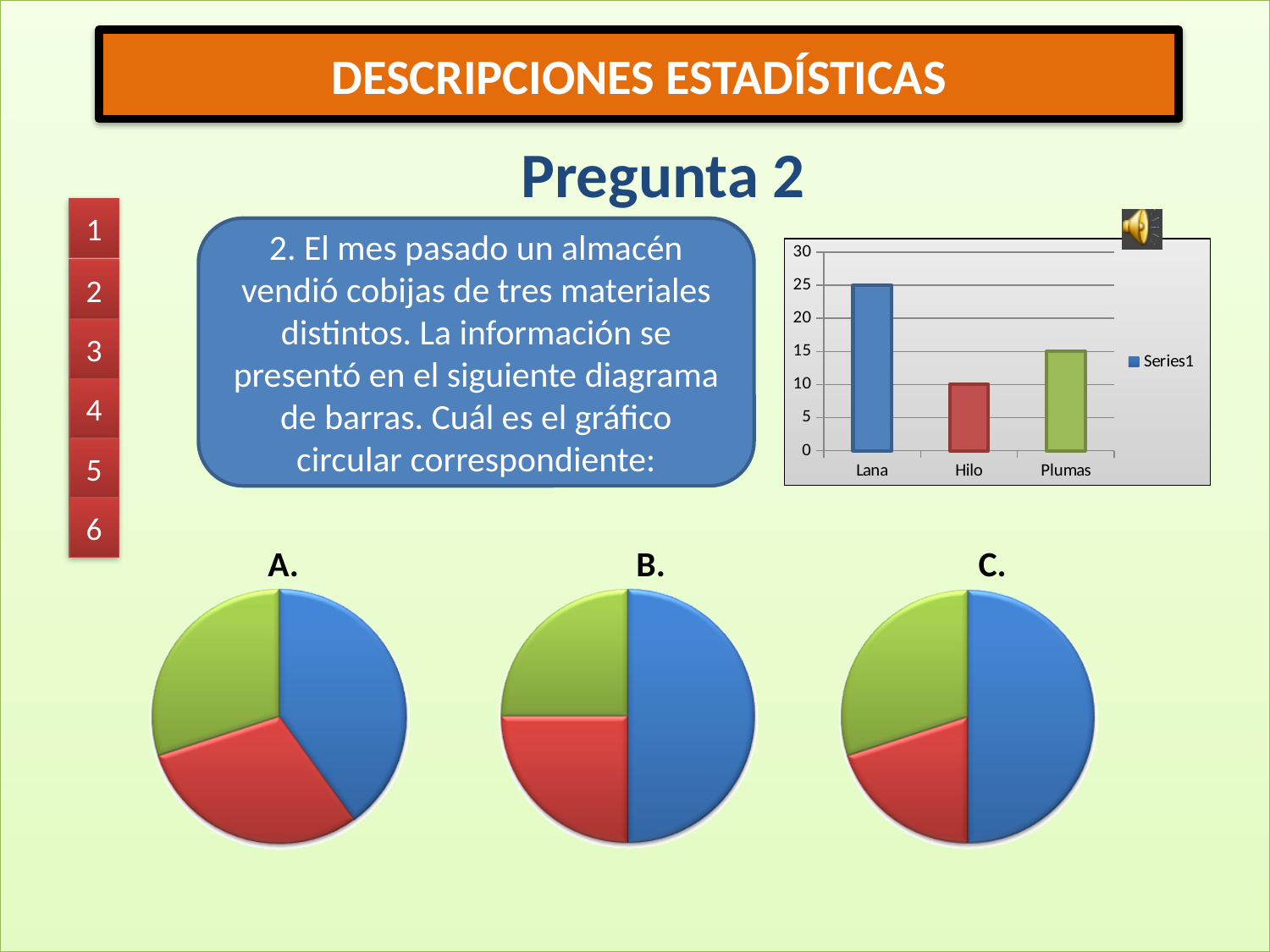
In the bar chart at the top right, which category has the highest value? Lana In the bar chart at the top right, what is the value for Hilo? 10 In the bar chart at the top right, what is the difference between the values for Lana and Hilo? 15 What kind of chart is the chart at the top right of the slide? bar chart In the bar chart at the top right, which category has the lowest value? Hilo In the bar chart at the top right, what is the value for Lana? 25 How many series does the legend of the bar chart at the top right list? 1 What kind of chart is chart B at the bottom of the slide? pie chart In the bar chart at the top right, which is larger, the value for Plumas or the value for Hilo? Plumas How many categories are shown in the bar chart at the top right? 3 In the bar chart at the top right, what is the value for Plumas? 15 In the bar chart at the top right, is the value for Lana greater or less than 20? greater